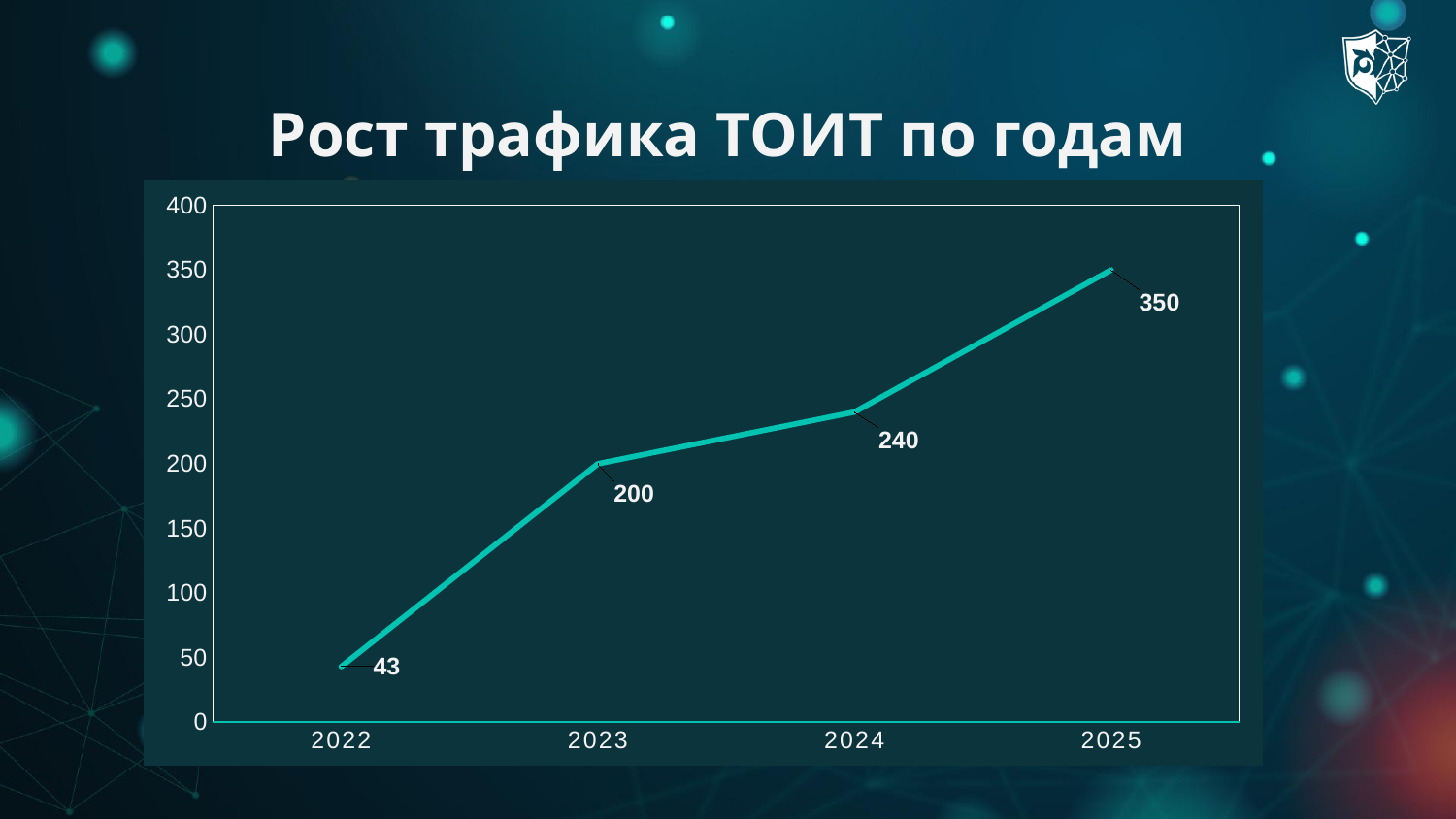
What is the value for 2023? 200 Which year has the highest value? 2025 What is the value for 2024? 240 What is the value for 2025? 350 Do the values rise or fall from 2022 to 2025? rise How many years are plotted on the chart? 4 Which year has the lowest value? 2022 Which is larger, the value for 2023 or the value for 2024? 2024 What is the difference between the values for 2025 and 2024? 110 What is the value for 2022? 43 What kind of chart is this? line chart What is the difference between the values for 2023 and 2022? 157